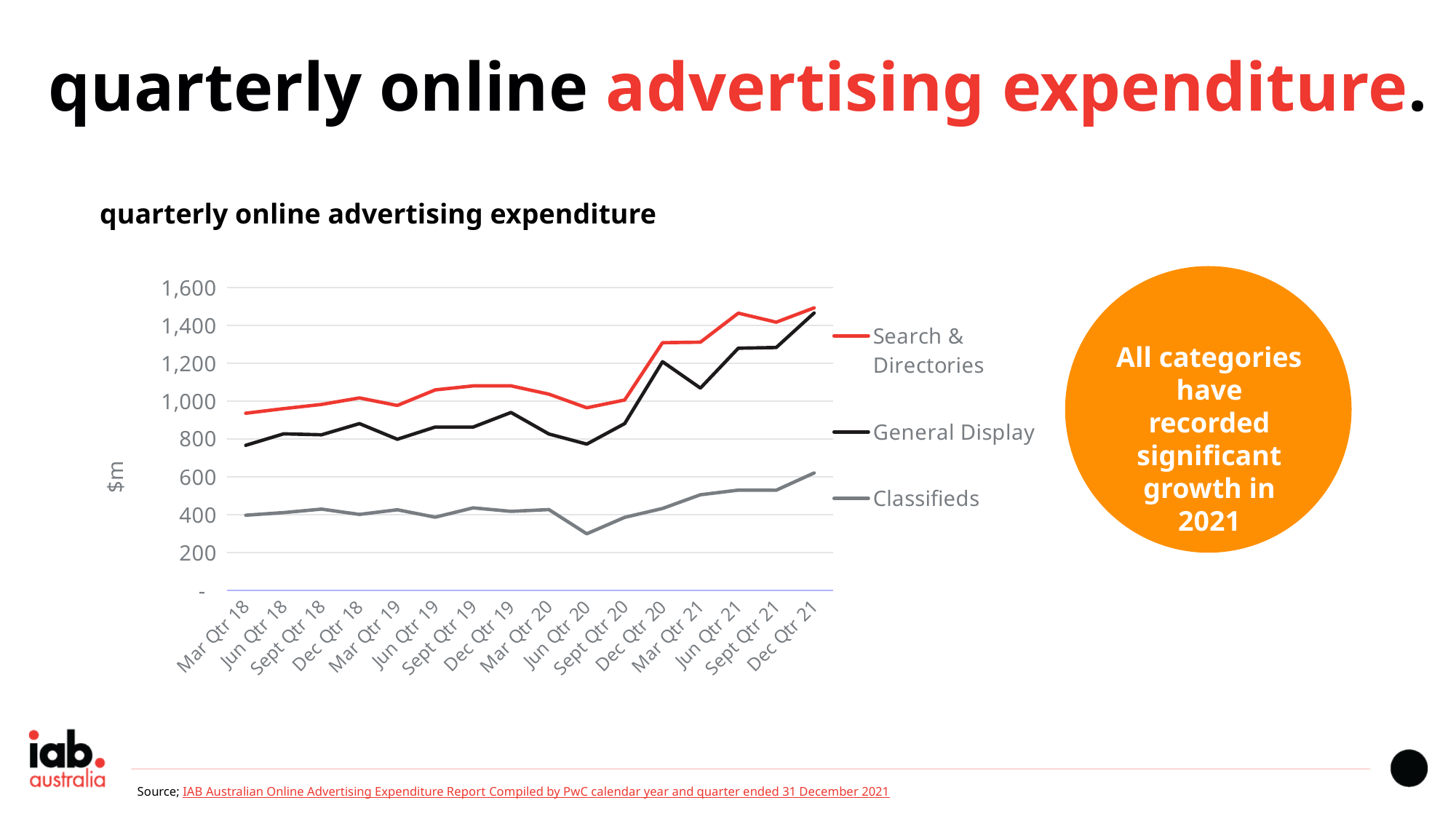
Is the value for Search & Directories in Dec Qtr 21 greater or less than 1,400? greater Which series has the highest values across the chart? Search & Directories How many series does the legend list? 3 In which quarter does the Search & Directories line reach its highest point? Dec Qtr 21 Is the value for Classifieds in Jun Qtr 20 greater or less than 400? less How many quarters are plotted along the x axis? 16 Does the Classifieds line rise or fall from Jun Qtr 20 to Dec Qtr 21? Rise What unit is shown on the y axis label? $m Is the value for Classifieds in Dec Qtr 21 greater or less than 600? greater What kind of chart is shown on the slide? Line chart Which is larger in Mar Qtr 18: General Display or Classifieds? General Display In which quarter does the Classifieds line reach its lowest point? Jun Qtr 20